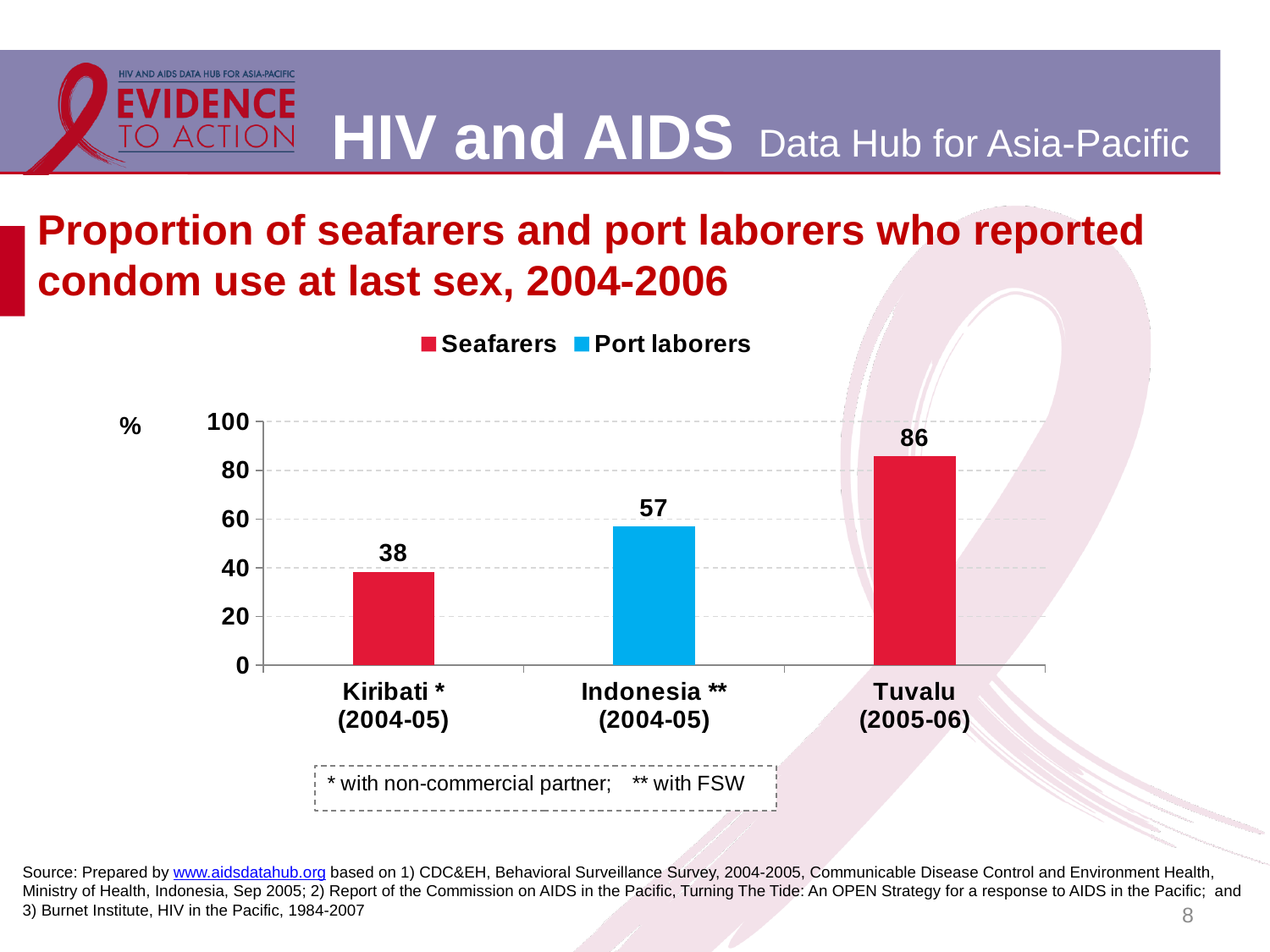
Which country has the highest reported condom use at last sex? Tuvalu (2005-06) What is the difference between the values for Tuvalu and Kiribati? 48 What kind of chart is shown on the slide? Bar chart What is the value for Kiribati (2004-05)? 38 How many series does the legend list? 2 Which is larger, the value for Indonesia or the value for Kiribati? Indonesia Is the value for Tuvalu greater or less than 80? greater What is the difference between the values for Indonesia and Kiribati? 19 How many countries are shown on the chart? 3 What is the value for Tuvalu (2005-06)? 86 Which country has the lowest reported condom use at last sex? Kiribati (2004-05) What is the value for Indonesia (2004-05)? 57